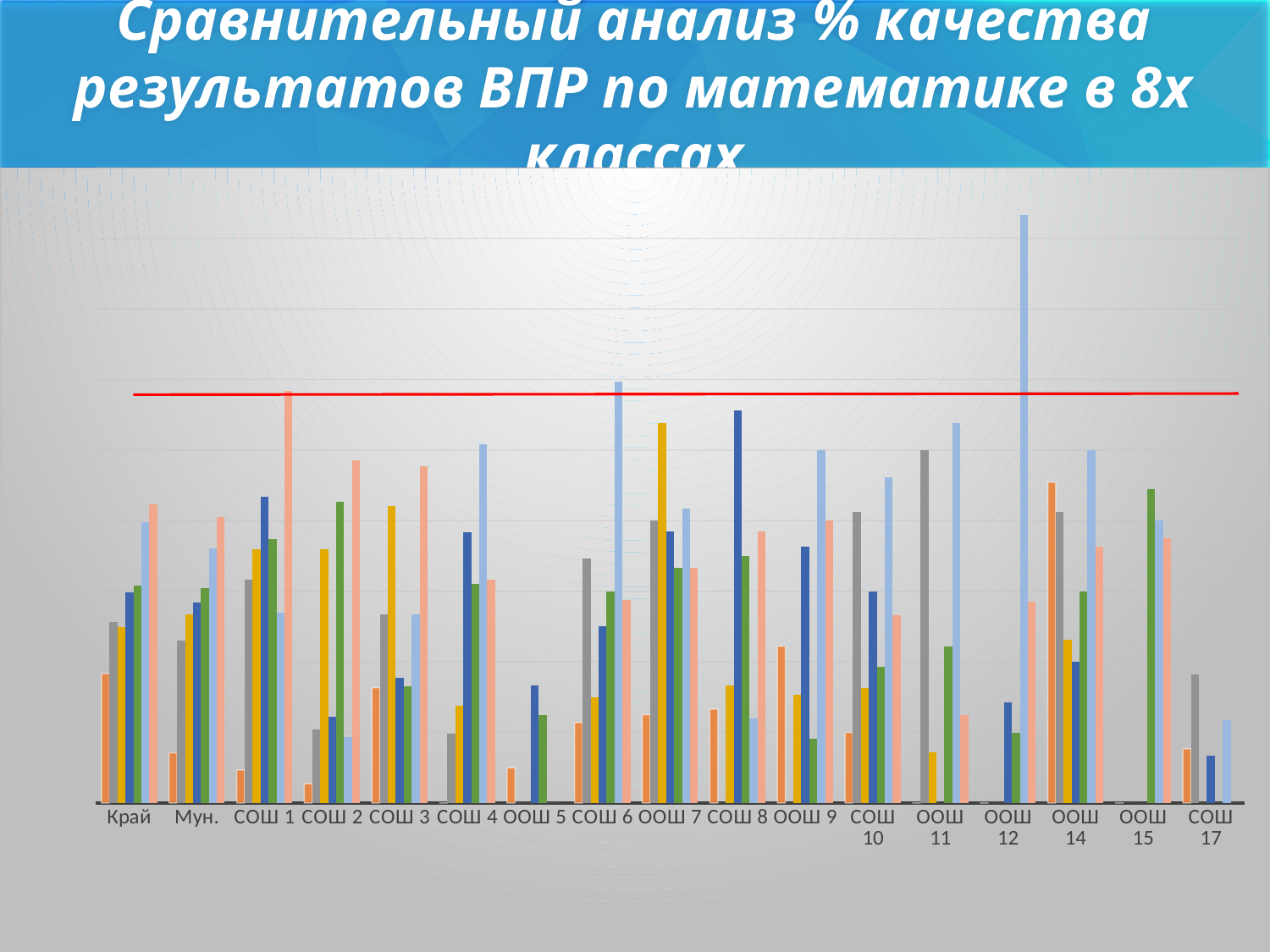
Which category has the tallest gold bar, ООШ 7 or ООШ 11? ООШ 7 What is the first category on the x axis of the chart? Край What is the last category on the x axis of the chart? СОШ 17 Is the tallest light blue bar in ООШ 12 or in СОШ 6? ООШ 12 Is the dark blue bar taller in СОШ 8 or in СОШ 17? СОШ 8 How many categories are shown along the x axis of the chart? 17 What kind of chart is shown on the slide? bar chart Which category contains the tallest bar in the whole chart? ООШ 12